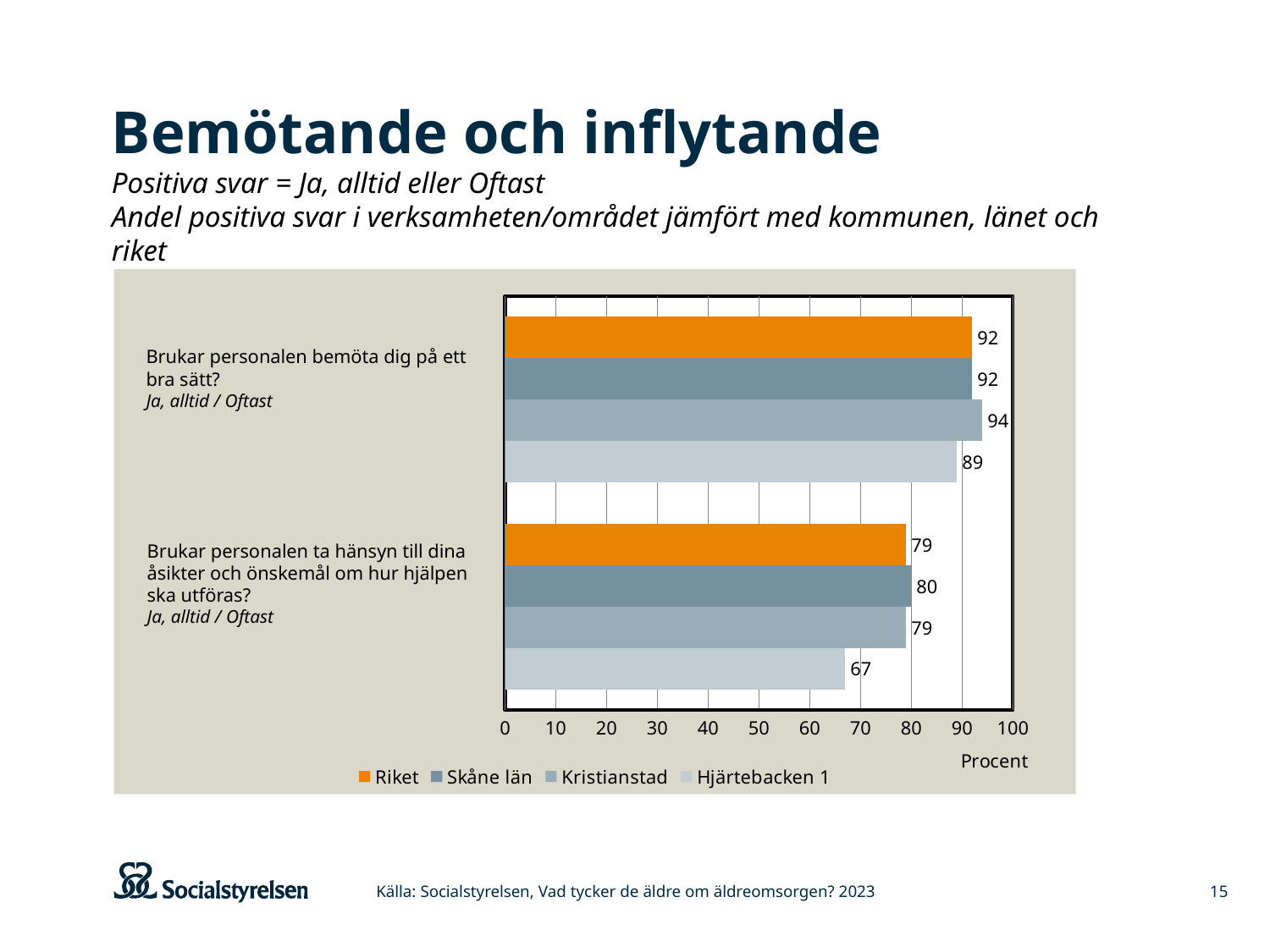
What is the value for Kristianstad on the question "Brukar personalen bemöta dig på ett bra sätt?"? 94 What is the difference between the Kristianstad value and the Hjärtebacken 1 value on the question "Brukar personalen bemöta dig på ett bra sätt?"? 5 Which series has the highest value on the question "Brukar personalen bemöta dig på ett bra sätt?"? Kristianstad What is the value for Hjärtebacken 1 on the question "Brukar personalen bemöta dig på ett bra sätt?"? 89 How many series does the legend list? 4 What is the value for Hjärtebacken 1 on the question "Brukar personalen ta hänsyn till dina åsikter och önskemål om hur hjälpen ska utföras?"? 67 Which is larger for Hjärtebacken 1: the value on "Brukar personalen bemöta dig på ett bra sätt?" or the value on "Brukar personalen ta hänsyn till dina åsikter och önskemål om hur hjälpen ska utföras?"? Brukar personalen bemöta dig på ett bra sätt? Which series has the lowest value on the question "Brukar personalen ta hänsyn till dina åsikter och önskemål om hur hjälpen ska utföras?"? Hjärtebacken 1 What is the value for Skåne län on the question "Brukar personalen ta hänsyn till dina åsikter och önskemål om hur hjälpen ska utföras?"? 80 What is the difference between the Riket value and the Hjärtebacken 1 value on the question "Brukar personalen ta hänsyn till dina åsikter och önskemål om hur hjälpen ska utföras?"? 12 What kind of chart is shown on the slide? bar chart What is the label of the horizontal axis? Procent